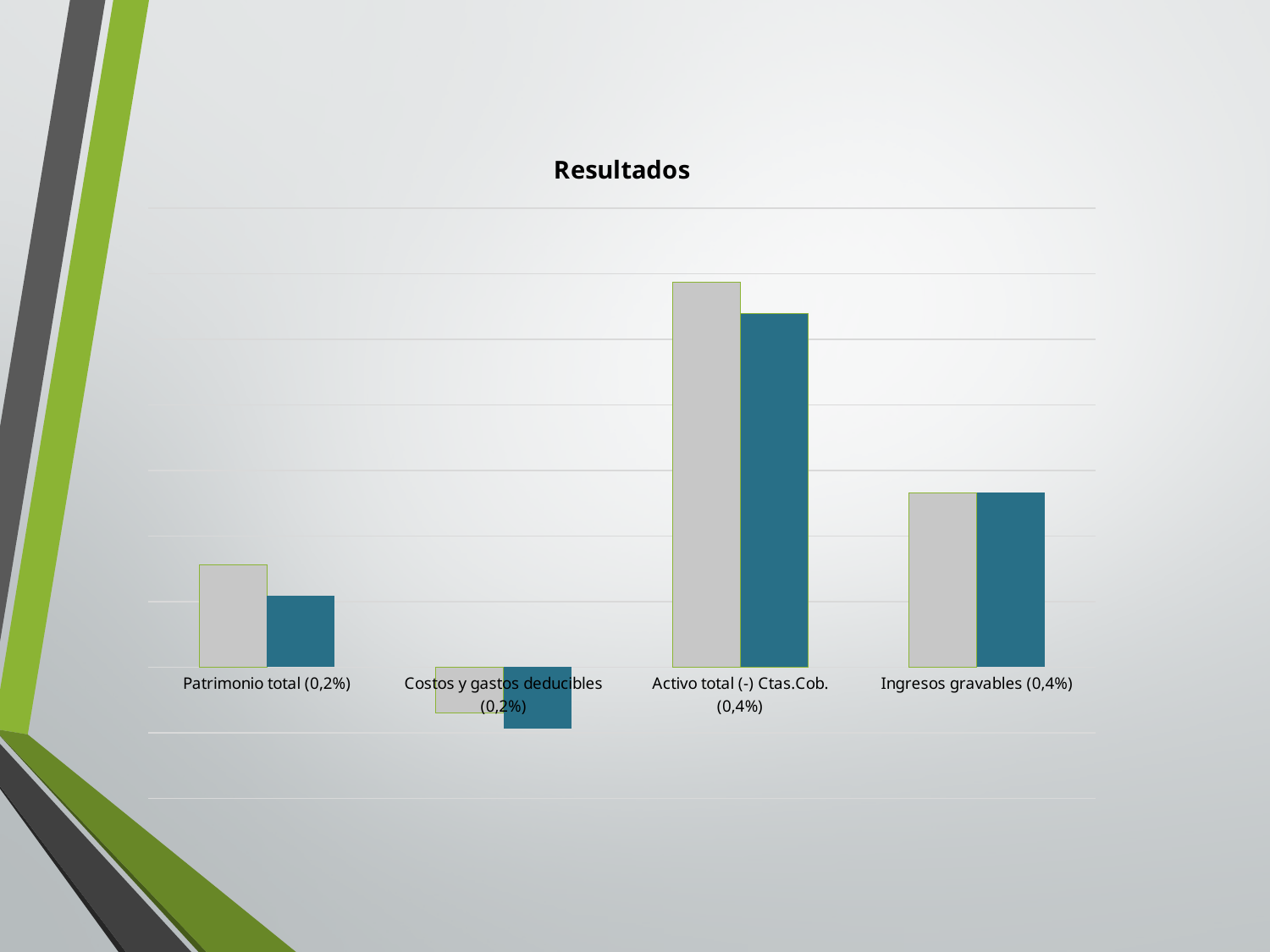
Which category has the tallest bars in the chart? Activo total (-) Ctas.Cob. (0,4%) What is the title of the chart? Resultados How many bars are plotted for each category in the chart? 2 What type of chart is shown on the slide? bar chart Which category has the lowest values in the chart? Costos y gastos deducibles (0,2%) Which category has higher bars, Costos y gastos deducibles (0,2%) or Patrimonio total (0,2%)? Patrimonio total (0,2%) For Patrimonio total (0,2%), which bar is taller, the grey one or the blue one? the grey one Which category is the second highest in the chart? Ingresos gravables (0,4%) How many categories are shown on the x axis of the chart? 4 Which category is the only one whose bars extend below the baseline? Costos y gastos deducibles (0,2%) Which category has higher bars, Patrimonio total (0,2%) or Ingresos gravables (0,4%)? Ingresos gravables (0,4%)